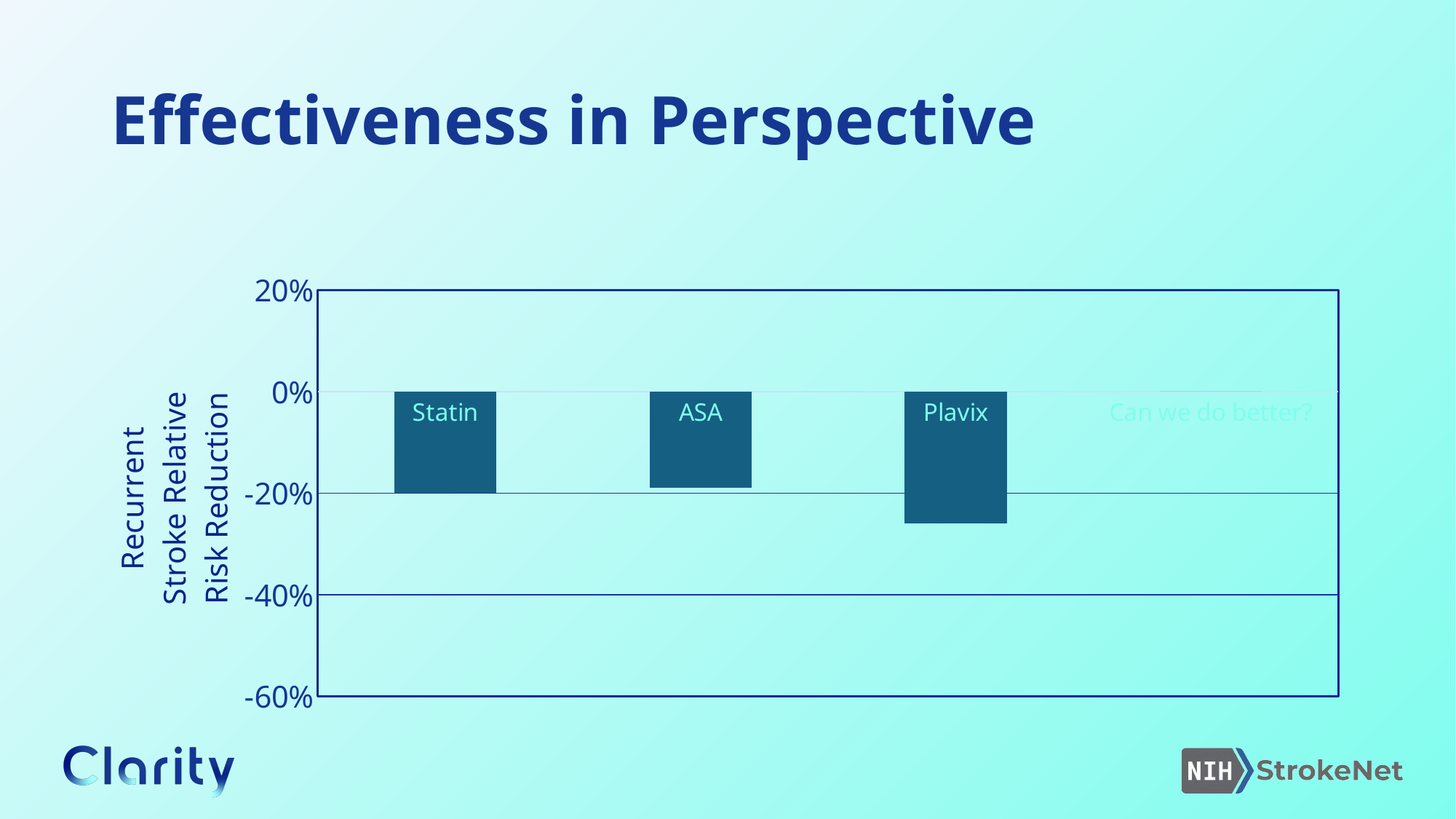
What is the label on the vertical axis of the chart? Recurrent Stroke Relative Risk Reduction What is the lowest value shown on the vertical axis? -60% What kind of chart is shown on the slide? bar chart Is the value for ASA greater or less than -40%? greater How many bars are plotted in the chart? 3 Which bar reaches a lower value, Plavix or Statin? Plavix Is the value for Plavix greater or less than -20%? less Is the value for Plavix greater or less than -40%? greater Which bar extends furthest below 0% in the chart? Plavix Which treatment shows the largest recurrent stroke relative risk reduction? Plavix